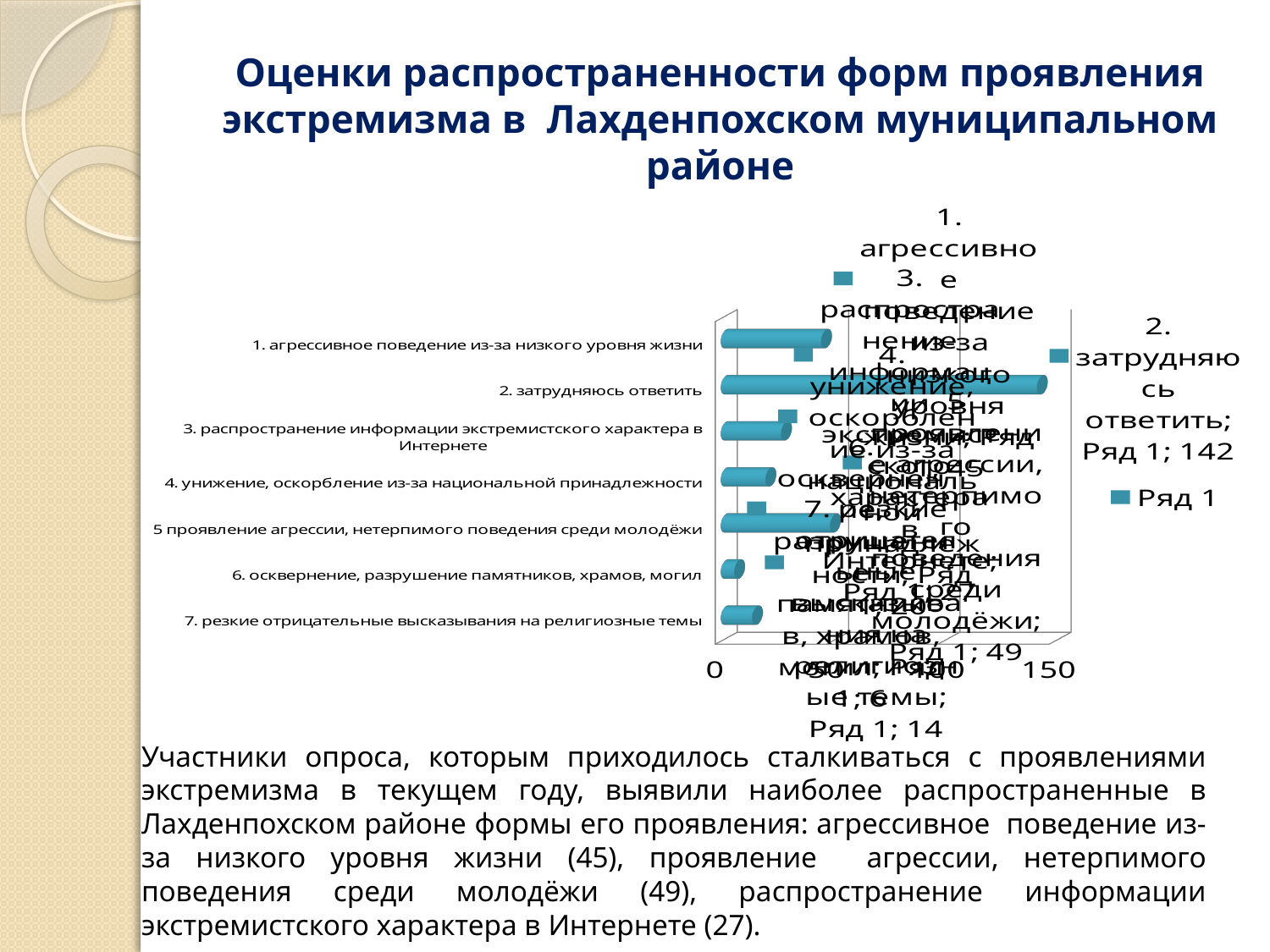
Is the value for "3. распространение информации экстремистского характера в Интернете" greater or less than 50? less What is the value for "7. резкие отрицательные высказывания на религиозные темы"? 14 How many series does the legend list? 1 What is the value for "5 проявление агрессии, нетерпимого поведения среди молодёжи"? 49 Is the value for "2. затрудняюсь ответить" greater or less than 100? greater How many categories does the chart show? 7 Which category has the highest value? 2. затрудняюсь ответить What is the difference between the values for "2. затрудняюсь ответить" and "5 проявление агрессии, нетерпимого поведения среди молодёжи"? 93 What is the name of the series shown in the legend? Ряд 1 Which is larger: the value for "1. агрессивное поведение из-за низкого уровня жизни" or for "3. распространение информации экстремистского характера в Интернете"? 1. агрессивное поведение из-за низкого уровня жизни What is the value for "2. затрудняюсь ответить"? 142 What kind of chart is shown on the slide? bar chart